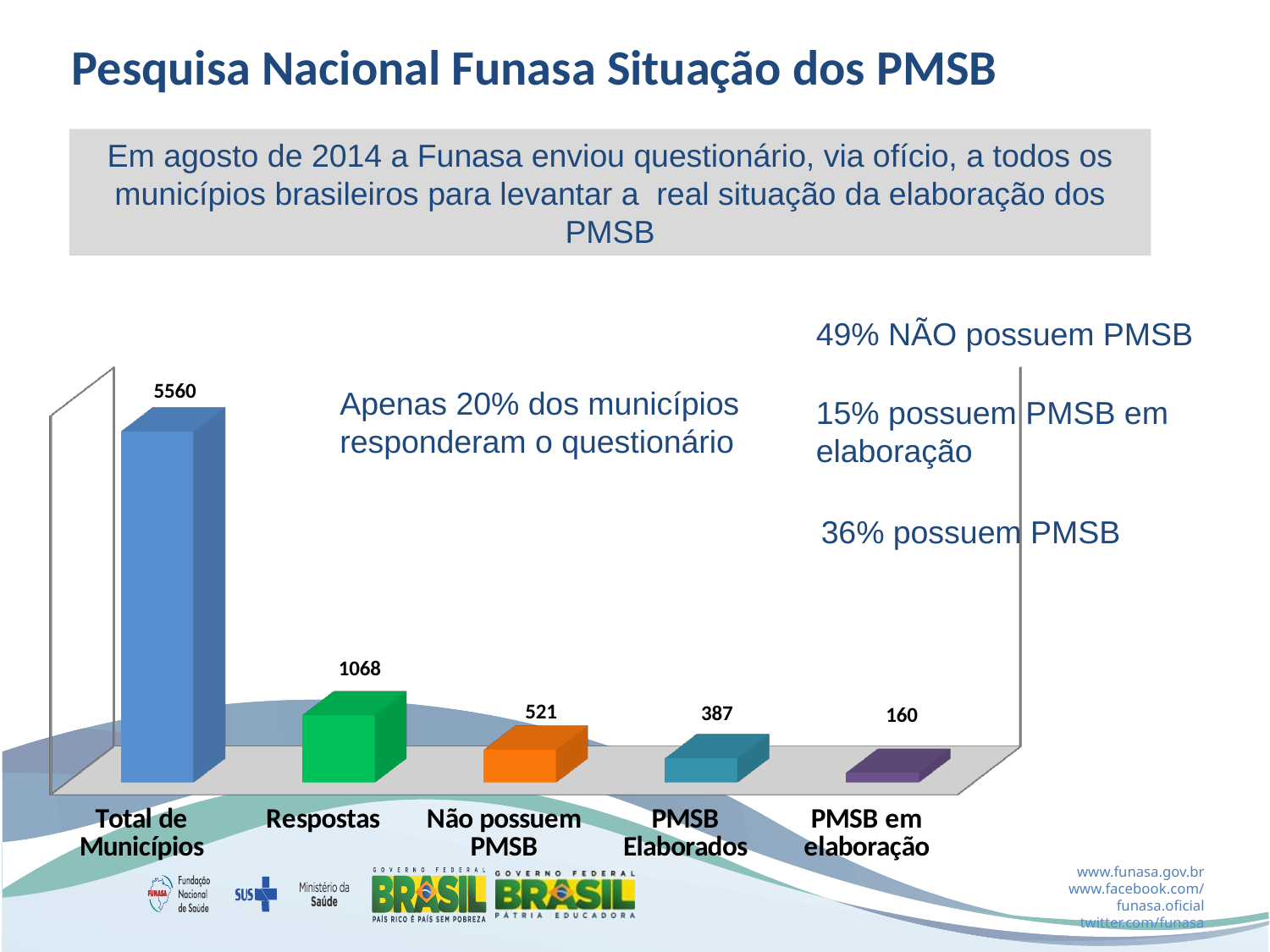
What is the difference between PMSB Elaborados and PMSB em elaboração? 227 What is the value for PMSB Elaborados? 387 What is the value for Não possuem PMSB? 521 What is the value for Respostas? 1068 What is the value for PMSB em elaboração? 160 What is the difference between Respostas and Não possuem PMSB? 547 Which category has the lowest value? PMSB em elaboração What kind of chart is shown on the slide? Bar chart Which is larger, Não possuem PMSB or PMSB Elaborados? Não possuem PMSB Which category has the highest value? Total de Municípios How many categories are shown in the chart? 5 What is the value for Total de Municípios? 5560